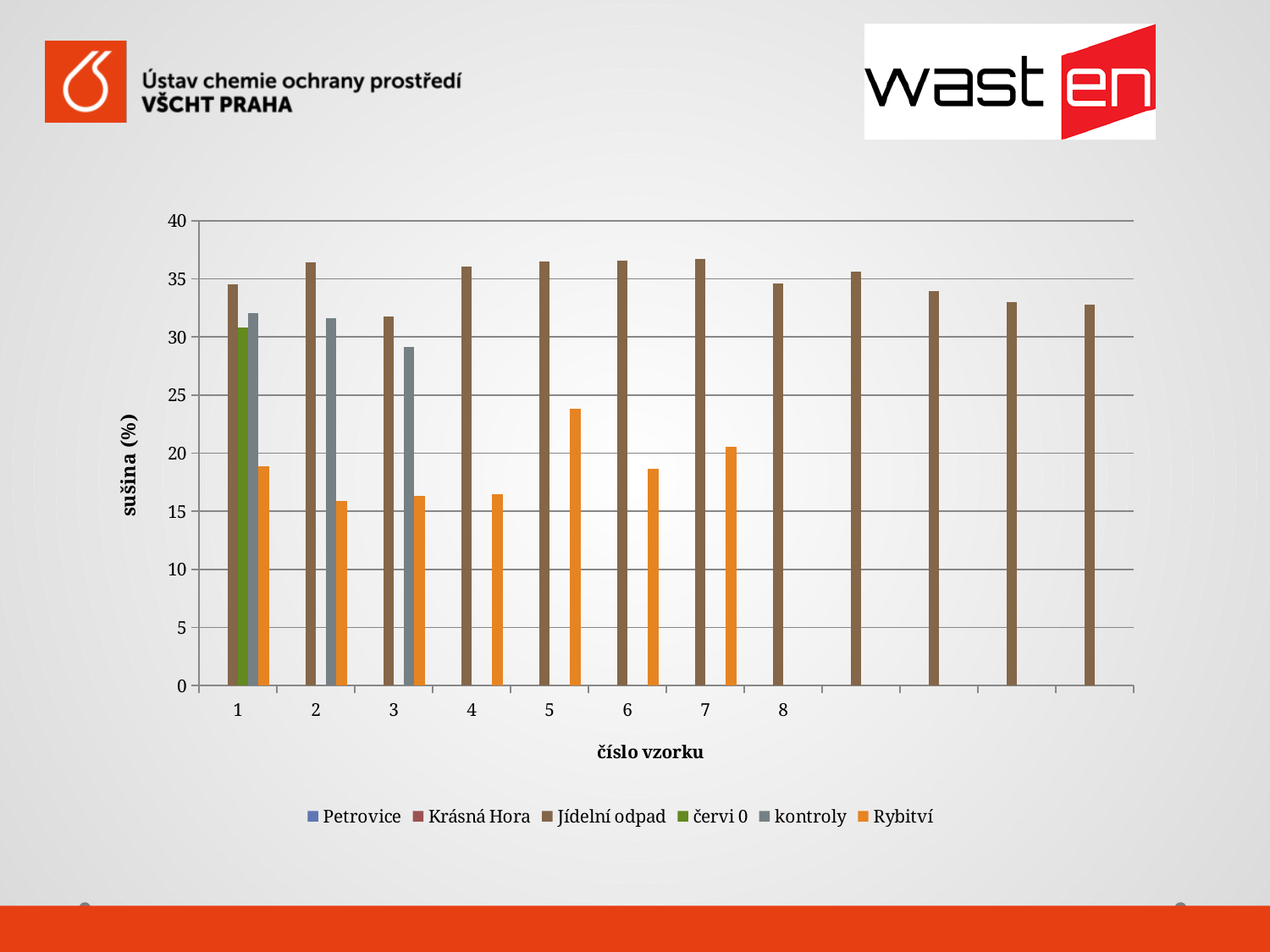
At sample 1, which is larger: Jídelní odpad or Rybitví? Jídelní odpad Is the value for Rybitví at sample 5 greater or less than 20? greater What is the title of the x axis? číslo vzorku Is the value for Rybitví at sample 1 greater or less than 20? less Is the value for kontroly at sample 3 greater or less than 30? less What is the title of the y axis? sušina (%) For the kontroly series, which is larger: the value at sample 2 or at sample 3? sample 2 At which sample number does the Jídelní odpad series have its lowest value? 3 At which sample number does the Rybitví series reach its highest value? 5 What kind of chart is shown on the slide? bar chart How many series does the legend list? 6